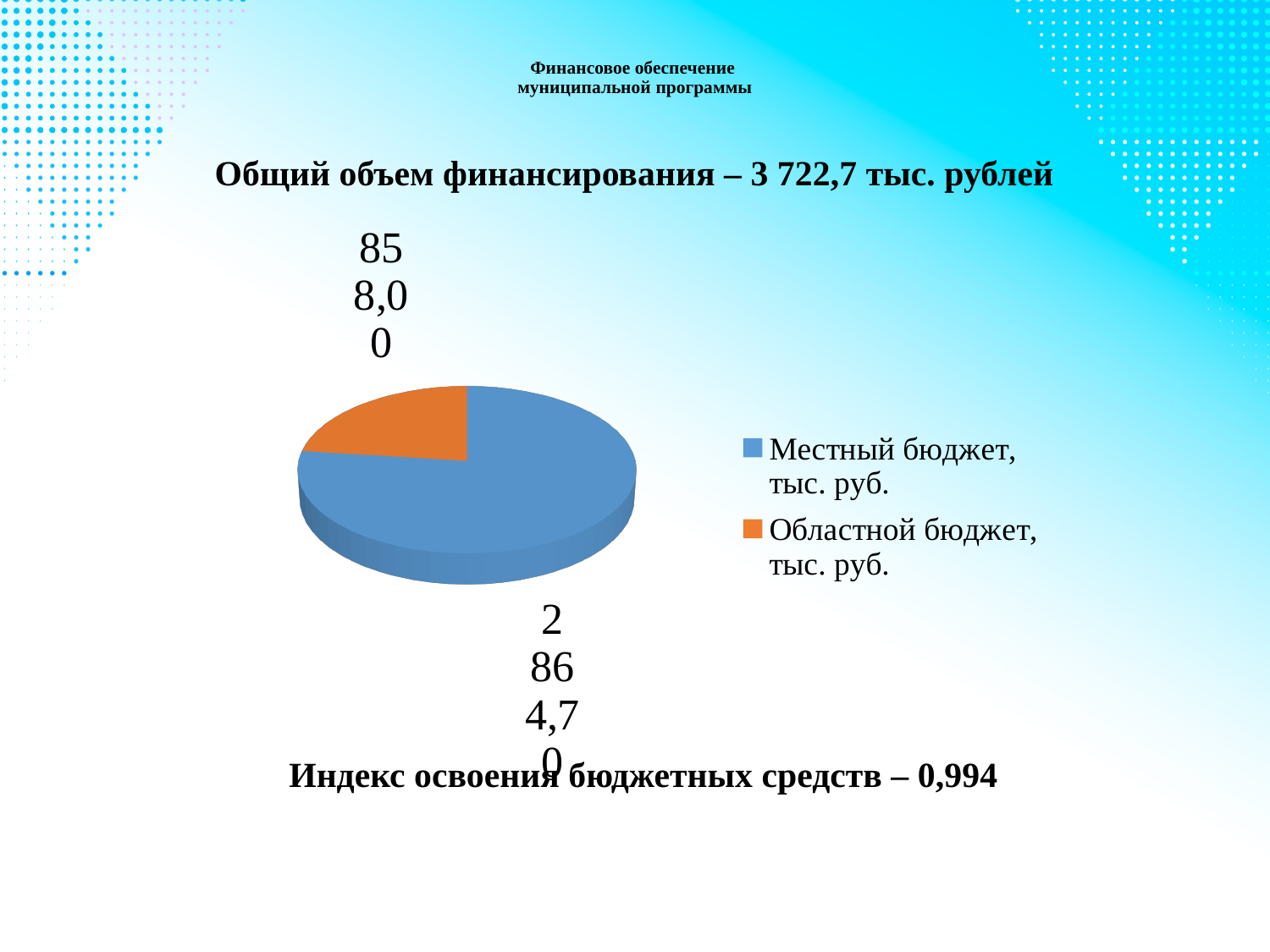
What is the value for Областной бюджет, тыс. руб.? 858,00 What total funding volume is stated above the chart? 3 722,7 тыс. рублей What kind of chart is shown on the slide? pie chart Which is larger, the value for Местный бюджет or for Областной бюджет? Местный бюджет How many slices does the pie chart have? 2 How many series does the legend list? 2 What colour is the slice for Областной бюджет? orange Which budget source has the largest slice of the pie? Местный бюджет, тыс. руб. Which budget source has the smallest slice of the pie? Областной бюджет, тыс. руб. What is the difference between the value for Местный бюджет and the value for Областной бюджет, in тыс. руб.? 2 006,70 What is the value for Местный бюджет, тыс. руб.? 2 864,70